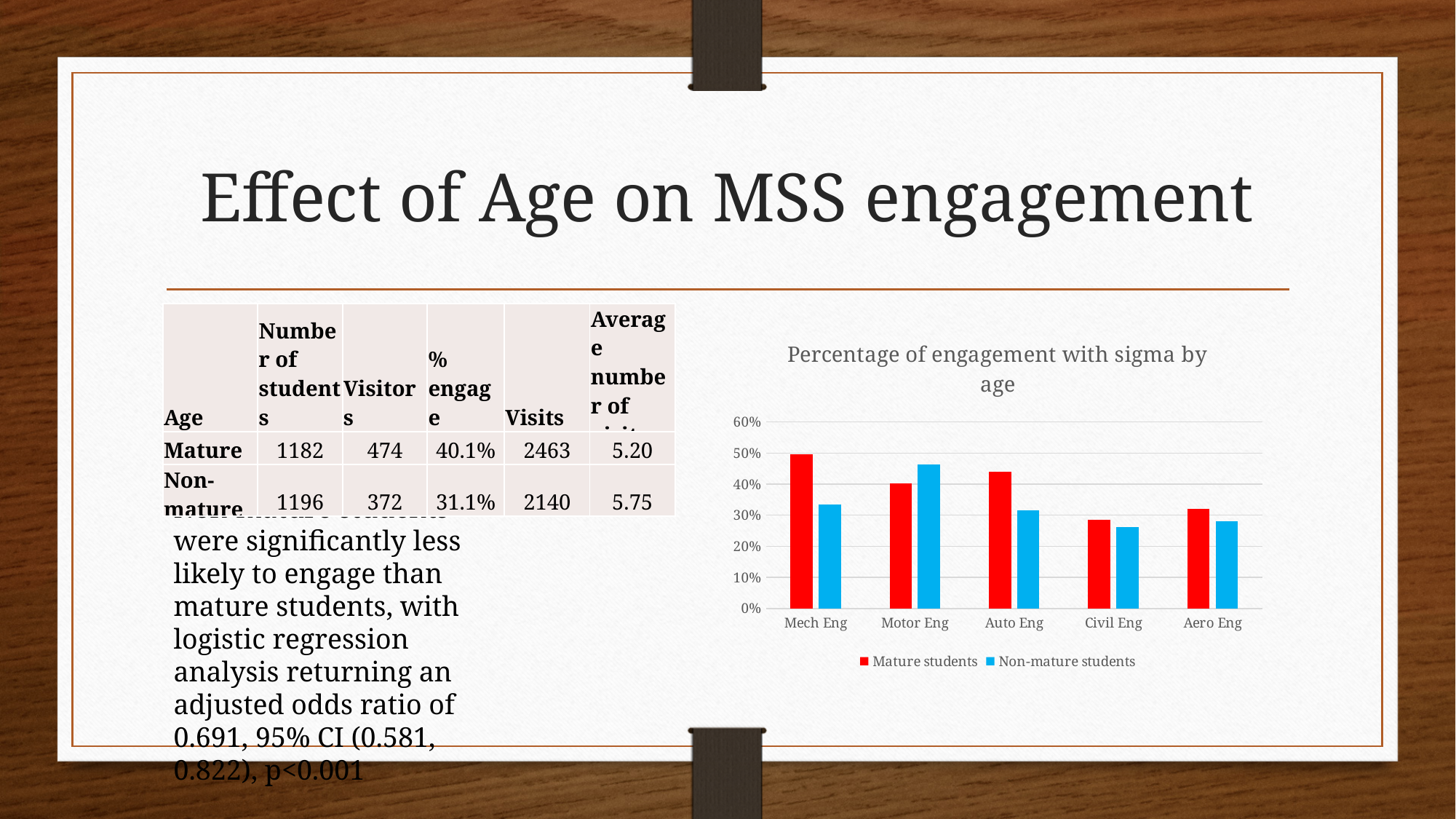
Is the Non-mature students value for Motor Eng greater or less than 40%? greater What is the title of the chart on the slide? Percentage of engagement with sigma by age Which colour represents Non-mature students in the chart? blue Is the Mature students value for Mech Eng greater or less than 40%? greater What kind of chart is shown on the slide? bar chart For which category is the Non-mature students value highest? Motor Eng Is the Mature students value for Civil Eng greater or less than 30%? less How many series does the chart's legend list? 2 How many engineering categories are shown on the x axis of the chart? 5 For which category is the Mature students value lowest? Civil Eng For Motor Eng, which is larger: the Mature students value or the Non-mature students value? Non-mature students For which category is the Mature students value highest? Mech Eng